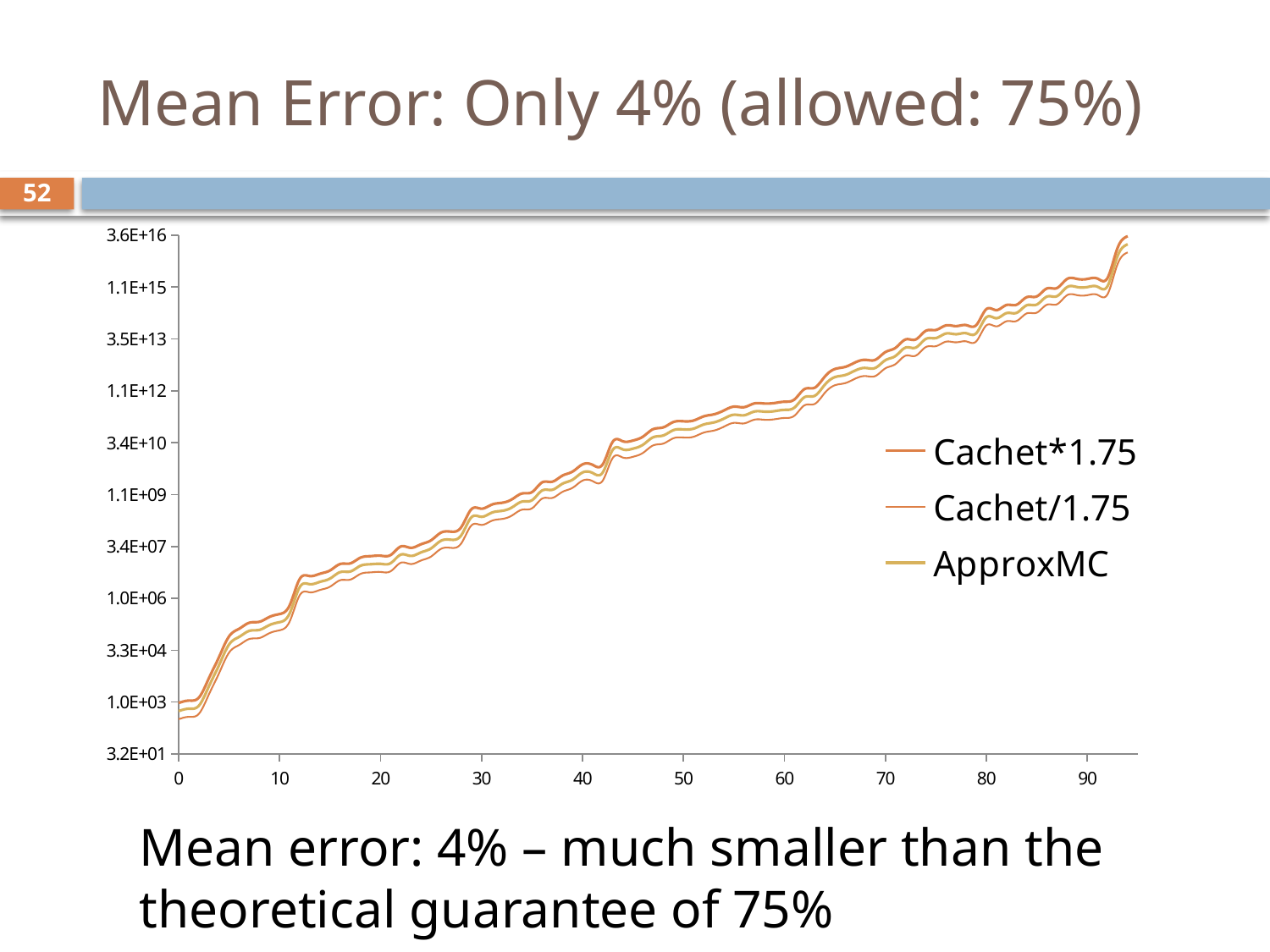
What is the largest tick label shown on the x axis? 90 What kind of chart is shown on the slide? line chart Which series is plotted as the topmost line, Cachet*1.75 or Cachet/1.75? Cachet*1.75 Which series lies between the other two lines on the chart? ApproxMC How many series does the legend list? 3 Is the Cachet*1.75 value at x = 90 greater or less than 3.5E+13? greater Is the ApproxMC value at x = 50 greater or less than 1.1E+12? less Which series are listed in the legend? Cachet*1.75, Cachet/1.75, ApproxMC What is the highest tick label shown on the y axis? 3.6E+16 Do the plotted values rise or fall as the x axis increases from 0 to 90? rise Is the ApproxMC value at x = 10 greater or less than 1.0E+06? less How many tick labels are shown on the x axis? 10